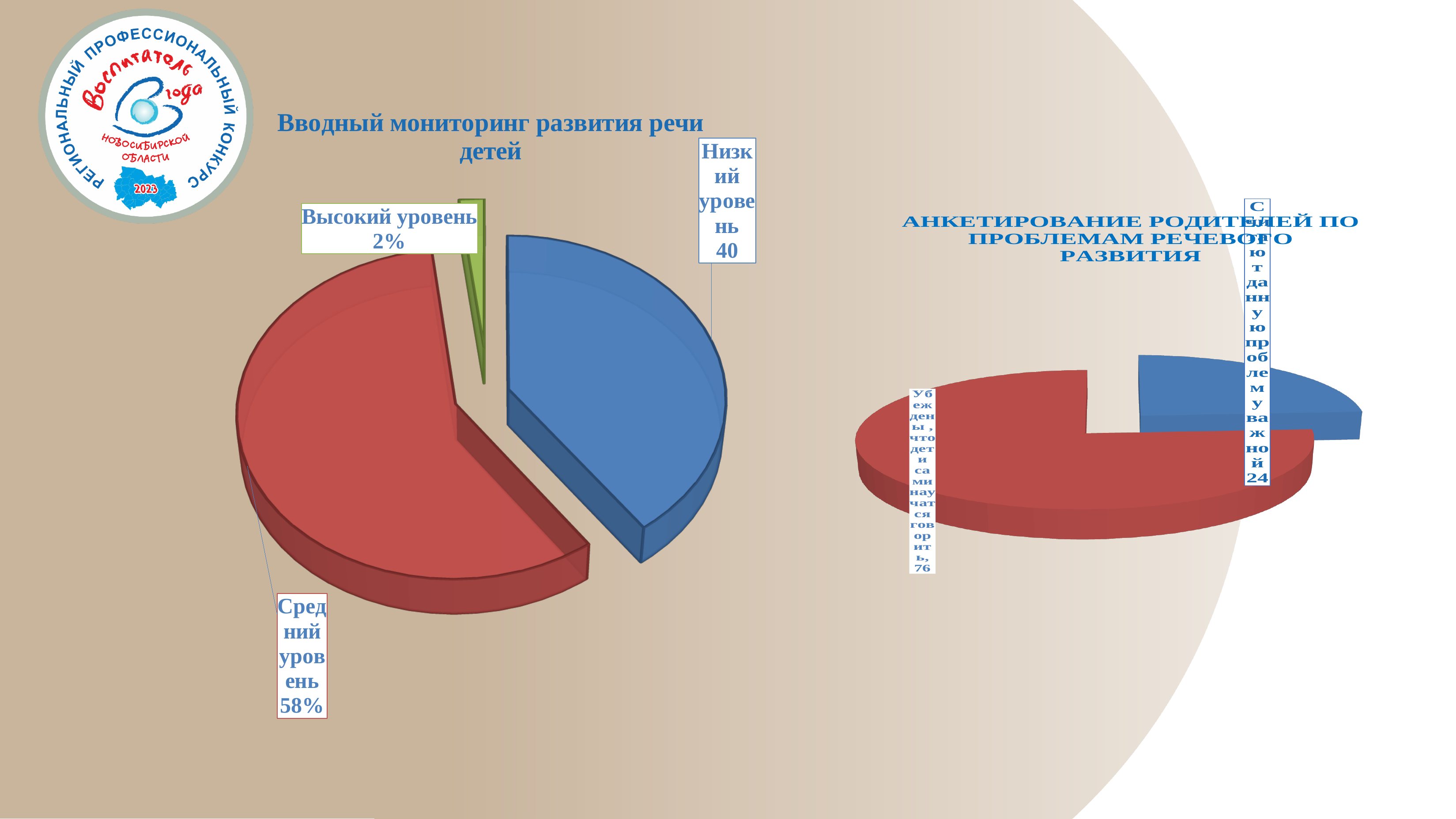
In the chart titled "Вводный мониторинг развития речи детей", what value is shown for "Низкий уровень"? 40 What type of chart is the one on the left of the slide? Pie chart In the chart titled "Вводный мониторинг развития речи детей", how many slices does the pie have? 3 In the chart titled "Вводный мониторинг развития речи детей", what colour is the "Средний уровень" slice? Red In the chart titled "АНКЕТИРОВАНИЕ РОДИТЕЛЕЙ ПО ПРОБЛЕМАМ РЕЧЕВОГО РАЗВИТИЯ", how many slices does the pie have? 2 In the chart titled "АНКЕТИРОВАНИЕ РОДИТЕЛЕЙ ПО ПРОБЛЕМАМ РЕЧЕВОГО РАЗВИТИЯ", what value is shown for "Считают данную проблему важной"? 24 In the chart titled "Вводный мониторинг развития речи детей", what value is shown for "Высокий уровень"? 2% In the chart titled "АНКЕТИРОВАНИЕ РОДИТЕЛЕЙ ПО ПРОБЛЕМАМ РЕЧЕВОГО РАЗВИТИЯ", what value is shown for "Убеждены, что дети сами научатся говорить"? 76 In the chart titled "АНКЕТИРОВАНИЕ РОДИТЕЛЕЙ ПО ПРОБЛЕМАМ РЕЧЕВОГО РАЗВИТИЯ", what is the difference between the two slice values? 52 In the chart titled "Вводный мониторинг развития речи детей", which level has the smallest slice? Высокий уровень In the chart titled "Вводный мониторинг развития речи детей", what value is shown for "Средний уровень"? 58% In the chart titled "Вводный мониторинг развития речи детей", which level has the largest slice? Средний уровень